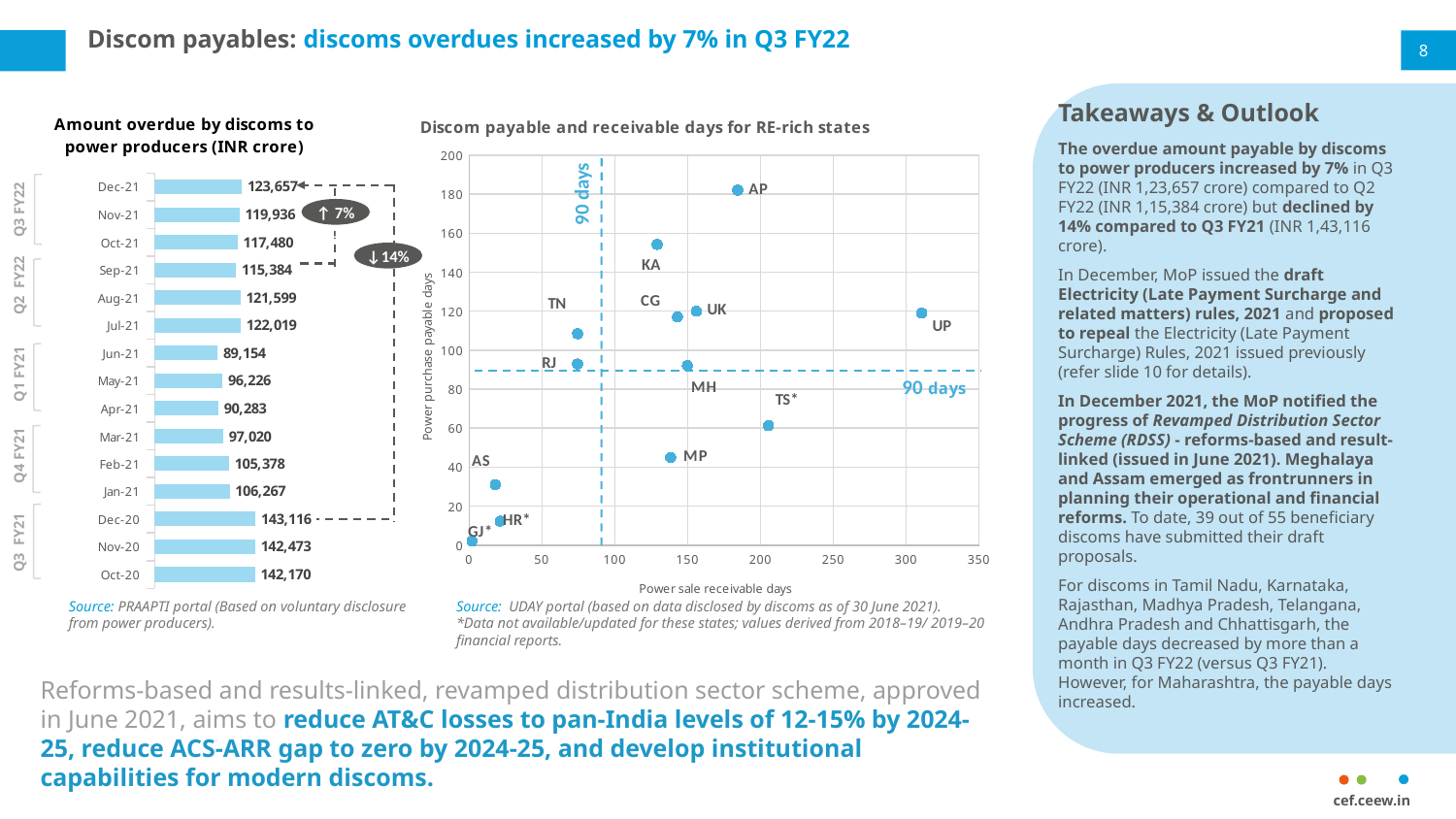
In the 'Amount overdue by discoms to power producers' chart, which is larger, the value for Aug-21 or the value for Jul-21? Jul-21 What type of chart is the 'Amount overdue by discoms to power producers' chart? Bar chart In the 'Amount overdue by discoms to power producers' chart, what is the difference between the Dec-21 and Sep-21 values? 8,273 What type of chart is the 'Discom payable and receivable days for RE-rich states' chart? Scatter chart In the 'Discom payable and receivable days for RE-rich states' chart, is the power purchase payable days value for AP greater or less than 160? greater In the 'Amount overdue by discoms to power producers' chart, what is the value for Dec-21? 123,657 In the 'Amount overdue by discoms to power producers' chart, what is the value for Sep-21? 115,384 How many months are shown in the 'Amount overdue by discoms to power producers' chart? 15 In the 'Amount overdue by discoms to power producers' chart, which month has the lowest overdue amount? Jun-21 In the 'Discom payable and receivable days for RE-rich states' chart, is the power sale receivable days value for UP greater or less than 300? greater In the 'Discom payable and receivable days for RE-rich states' chart, what is the label on the x axis? Power sale receivable days In the 'Amount overdue by discoms to power producers' chart, which month has the highest overdue amount? Dec-20